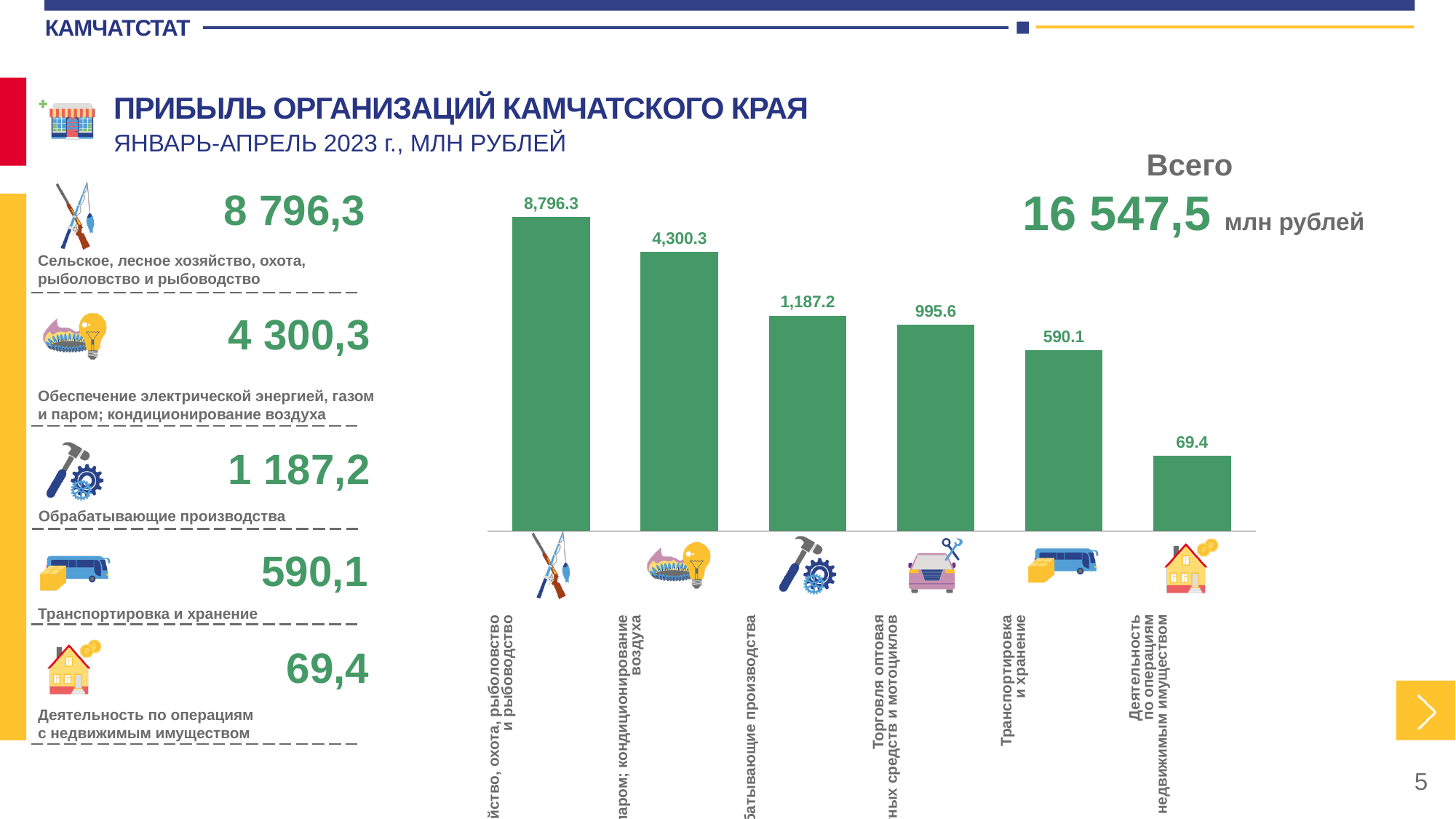
What type of chart is shown on the slide? Bar chart What is the value of the bar for Деятельность по операциям с недвижимым имуществом? 69.4 What is the difference between the bar for Сельское, лесное хозяйство, охота, рыболовство и рыбоводство and the bar for Обеспечение электрической энергией, газом и паром; кондиционирование воздуха? 4,496.0 Which is larger: the bar for Обрабатывающие производства or the bar for Транспортировка и хранение? Обрабатывающие производства What is the value of the bar for Транспортировка и хранение? 590.1 What is the value of the bar for Обрабатывающие производства? 1,187.2 What total value (Всего) is shown next to the chart? 16 547,5 млн рублей Which category has the highest bar in the chart? Сельское, лесное хозяйство, охота, рыболовство и рыбоводство Do the bar values rise or fall from left to right across the chart? Fall What is the value of the fourth bar from the left (Торговля оптовая ...)? 995.6 How many bars (categories) does the chart show? 6 Which category has the lowest bar in the chart? Деятельность по операциям с недвижимым имуществом